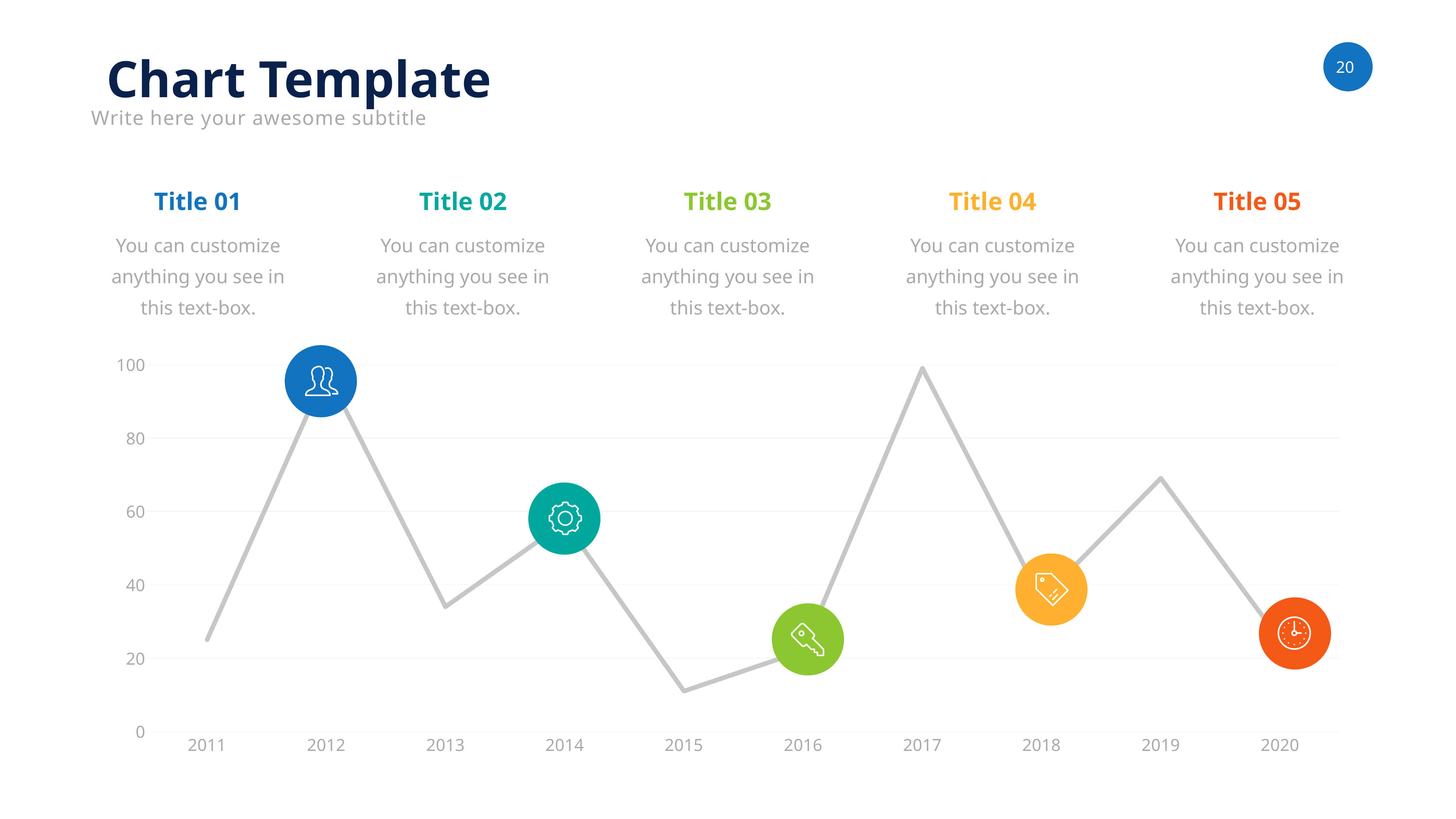
Is the value for 2015 greater or less than 20? less Does the line rise or fall from 2017 to 2018? fall Is the value for 2019 greater or less than 60? greater Which year has the lowest value on the chart? 2015 Is the value for 2014 greater or less than 40? greater What is the first year shown on the x axis? 2011 How many years are shown on the x axis of the chart? 10 Which is larger, the value for 2019 or the value for 2013? 2019 What kind of chart is shown on the slide? line chart